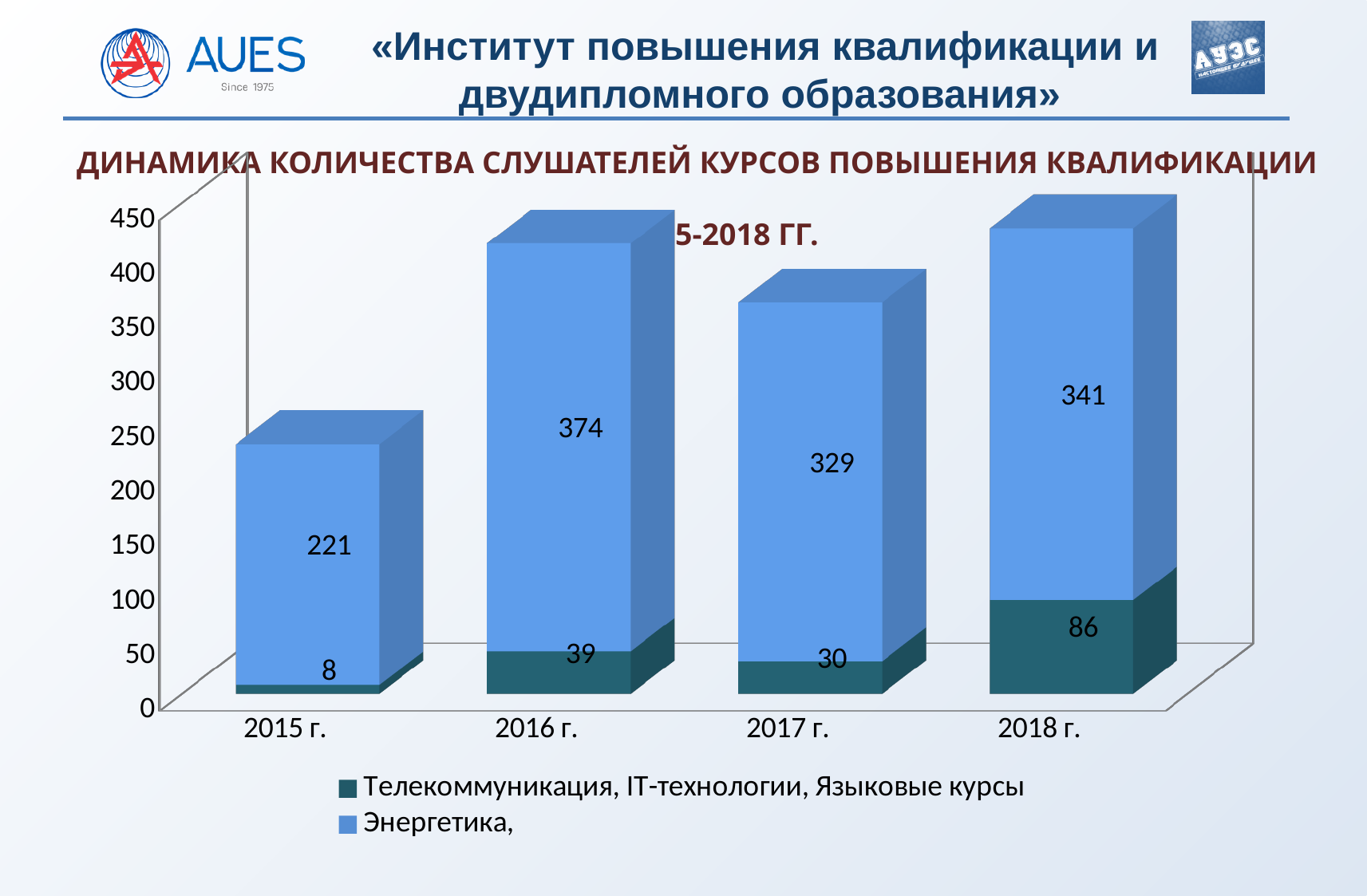
What is the total of the stacked bar for 2018 г.? 427 What is the value for Энергетика in 2015 г.? 221 Which year has the highest value for Энергетика? 2016 г. Which is larger: the Телекоммуникация, IT-технологии, Языковые курсы value for 2016 г. or for 2017 г.? 2016 г. What is the total of the stacked bar for 2015 г.? 229 Which year has the lowest value for Телекоммуникация, IT-технологии, Языковые курсы? 2015 г. What kind of chart is shown on the slide? Stacked bar chart How many years are shown on the x axis? 4 What is the value for Телекоммуникация, IT-технологии, Языковые курсы in 2018 г.? 86 What is the value for Энергетика in 2016 г.? 374 How many series does the legend list? 2 What is the difference between the Энергетика values for 2018 г. and 2017 г.? 12